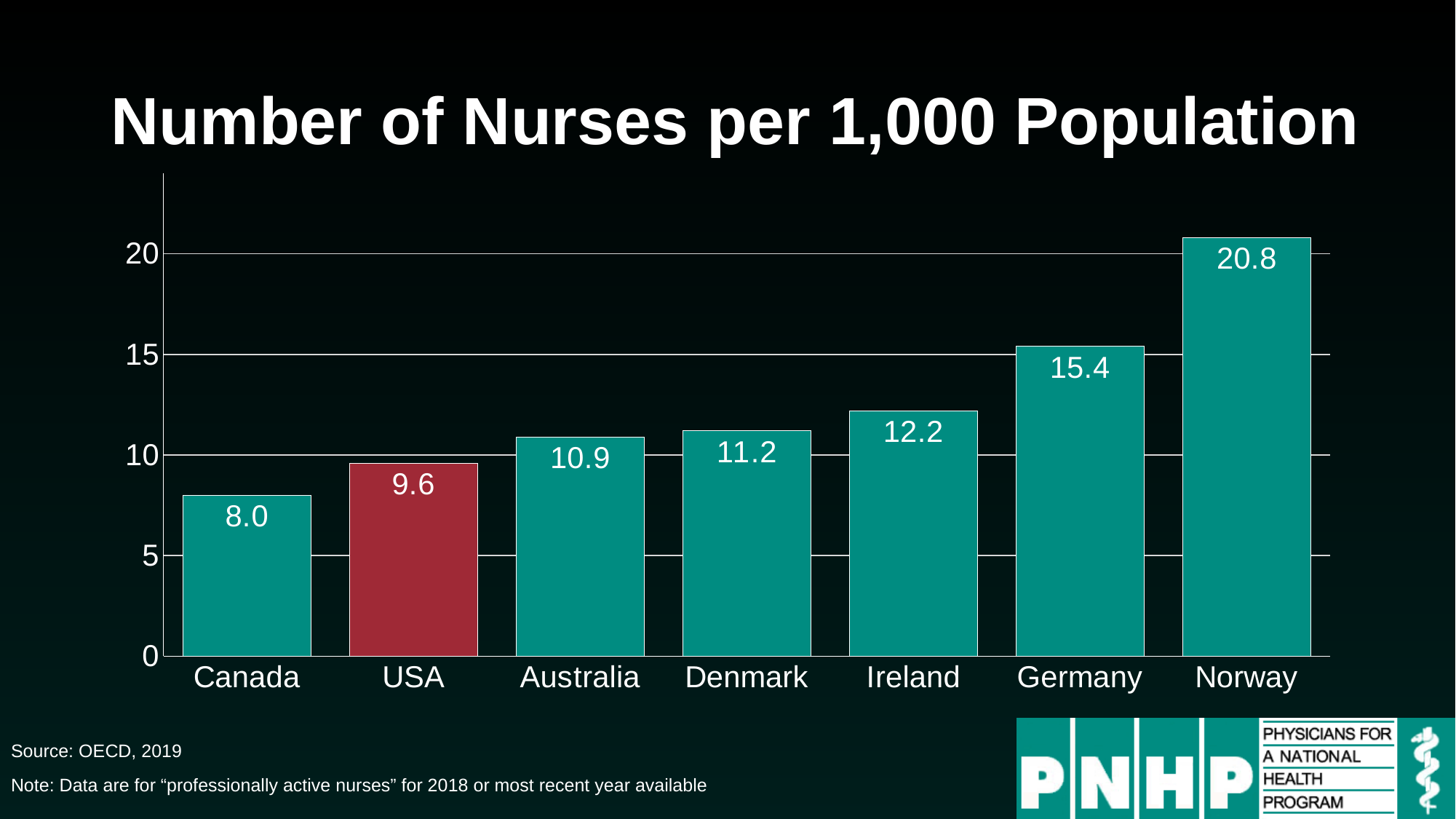
What is the difference between Ireland's and the USA's number of nurses per 1,000 population? 2.6 Which country has the lowest number of nurses per 1,000 population? Canada Which has more nurses per 1,000 population, Denmark or Australia? Denmark What is the difference between Norway's and Canada's number of nurses per 1,000 population? 12.8 How many countries are shown in the chart? 7 What kind of chart is shown on the slide? Bar chart What is the number of nurses per 1,000 population for Germany? 15.4 Which country has the highest number of nurses per 1,000 population? Norway Is the value for Germany greater or less than 15? greater Do the values rise or fall from left to right across the countries? Rise What is the number of nurses per 1,000 population for the USA? 9.6 Which country's bar is shown in a different colour (red) from the others? USA